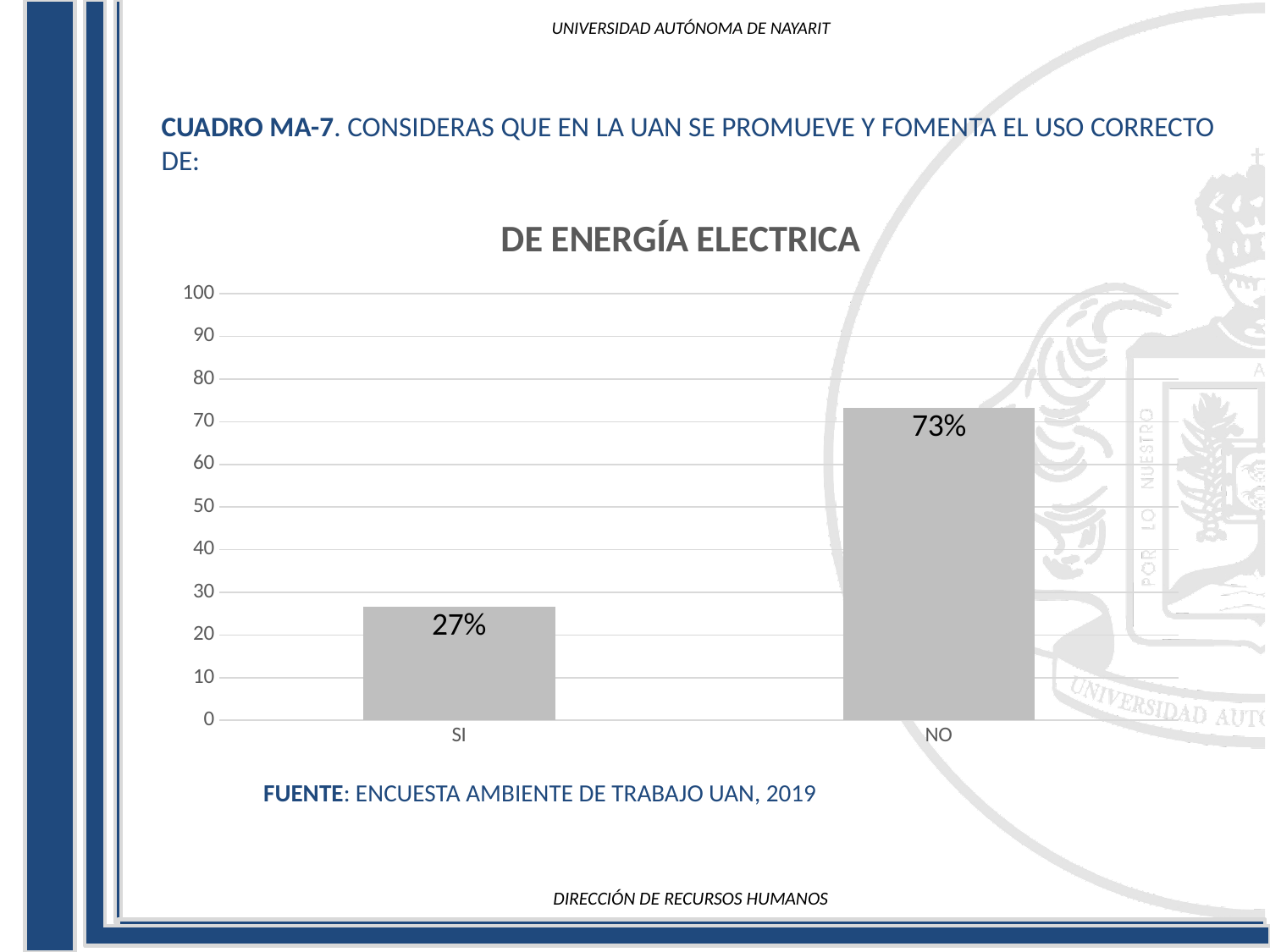
Which is larger, the value for SI or the value for NO? NO What is the value for NO? 73% How many categories are shown on the x axis? 2 What is the difference between the values for NO and SI? 46% Which category has the highest value? NO Is the value for NO greater or less than 70? greater What is the title of the chart? DE ENERGÍA ELECTRICA Which category has the lowest value? SI What is the maximum value shown on the y axis? 100 What is the value for SI? 27% What kind of chart is shown on the slide? bar chart Is the value for SI greater or less than 30? less